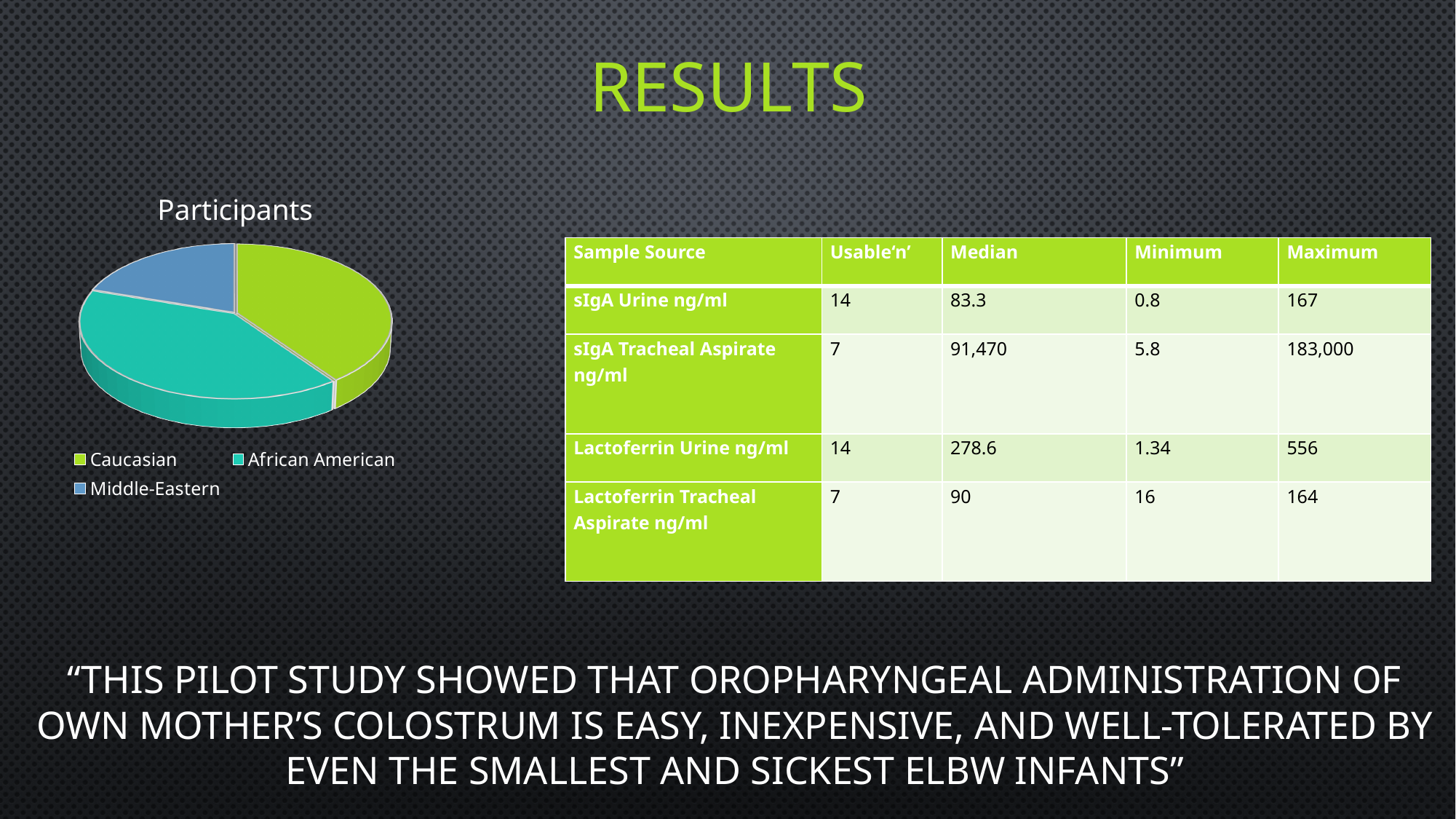
What is the title of the pie chart on the slide? Participants In the Participants pie chart, which slice is larger: Caucasian or Middle-Eastern? Caucasian Which colour represents Middle-Eastern in the Participants pie chart? blue In the Participants pie chart, which slice is larger: African American or Middle-Eastern? African American How many categories does the Participants pie chart show? 3 Which category has the smallest slice in the Participants pie chart? Middle-Eastern How many entries does the legend of the Participants chart list? 3 What kind of chart is the Participants chart? pie chart